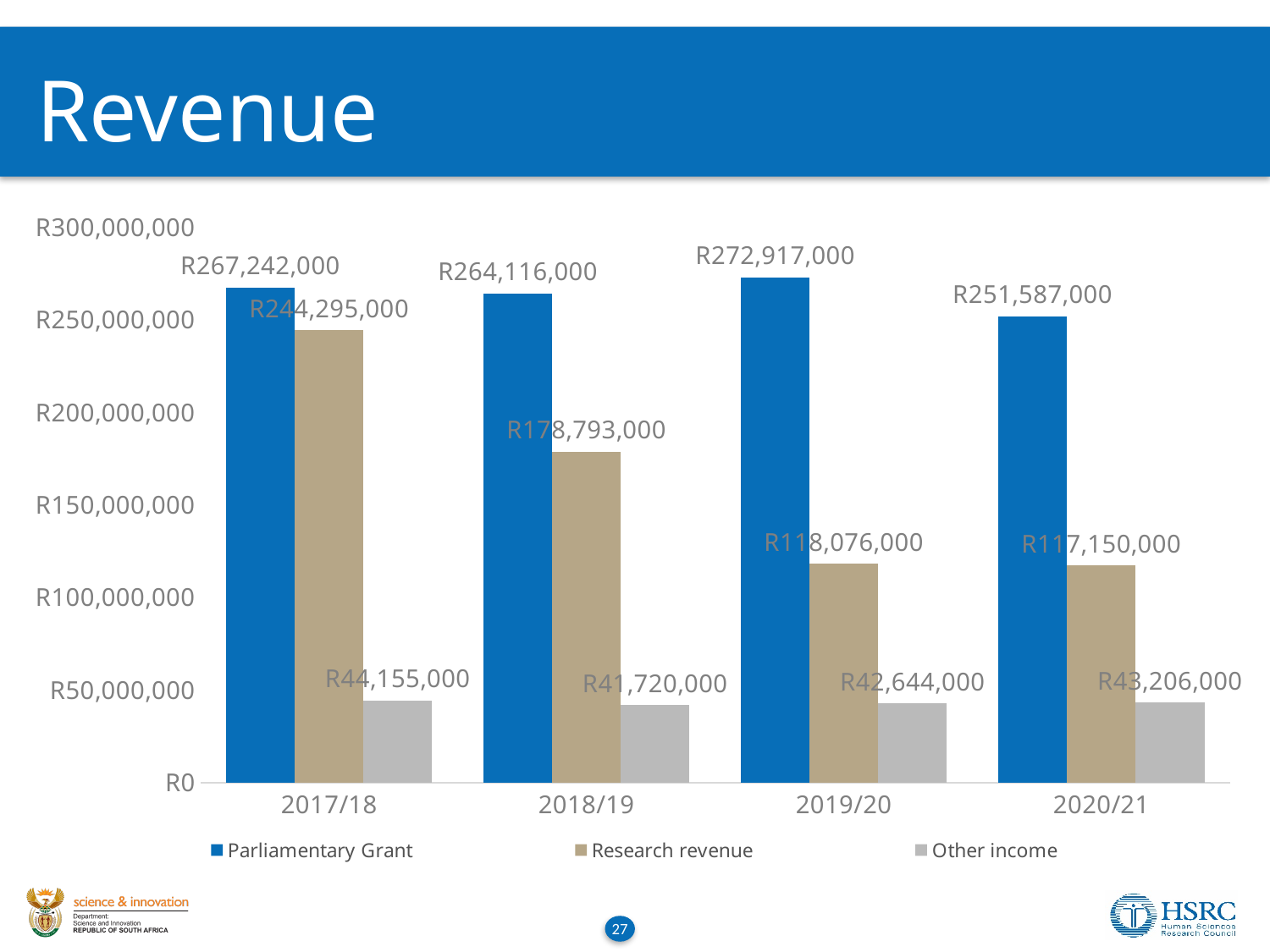
What is the Parliamentary Grant value for 2019/20? R272,917,000 How many series does the legend list? 3 Is the Research revenue value for 2019/20 greater or less than R150,000,000? less What kind of chart is shown on the slide? bar chart What is the difference between the Parliamentary Grant in 2019/20 and in 2020/21? R21,330,000 Does Research revenue rise or fall from 2017/18 to 2020/21? fall How many years are shown on the x axis? 4 Which is larger in 2017/18: Parliamentary Grant or Research revenue? Parliamentary Grant In which year is Research revenue lowest? 2020/21 In which year is the Parliamentary Grant highest? 2019/20 What is the Other income value for 2020/21? R43,206,000 What is the Research revenue value for 2018/19? R178,793,000